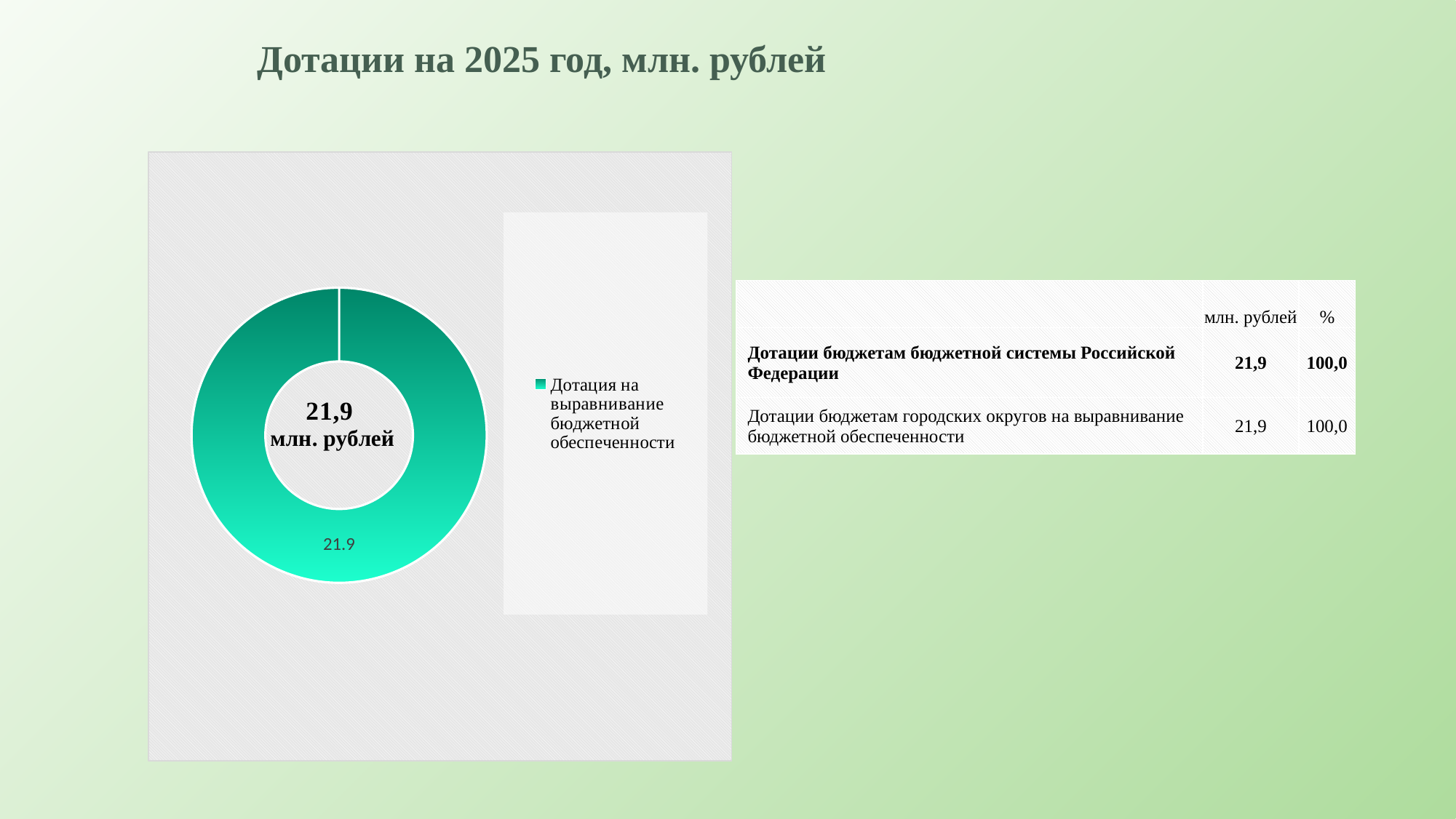
How many slices does the doughnut chart have? 1 Is the value of the chart's slice greater or less than 20? greater What kind of chart is shown on the slide? doughnut chart How many entries does the chart's legend list? 1 What share of the doughnut does the slice 'Дотация на выравнивание бюджетной обеспеченности' represent? 100% What value is shown in the centre of the doughnut chart? 21,9 млн. рублей What value is printed on the data label of the chart's slice? 21.9 What is the legend entry of the doughnut chart? Дотация на выравнивание бюджетной обеспеченности What colour is the slice of the doughnut chart? green (teal)